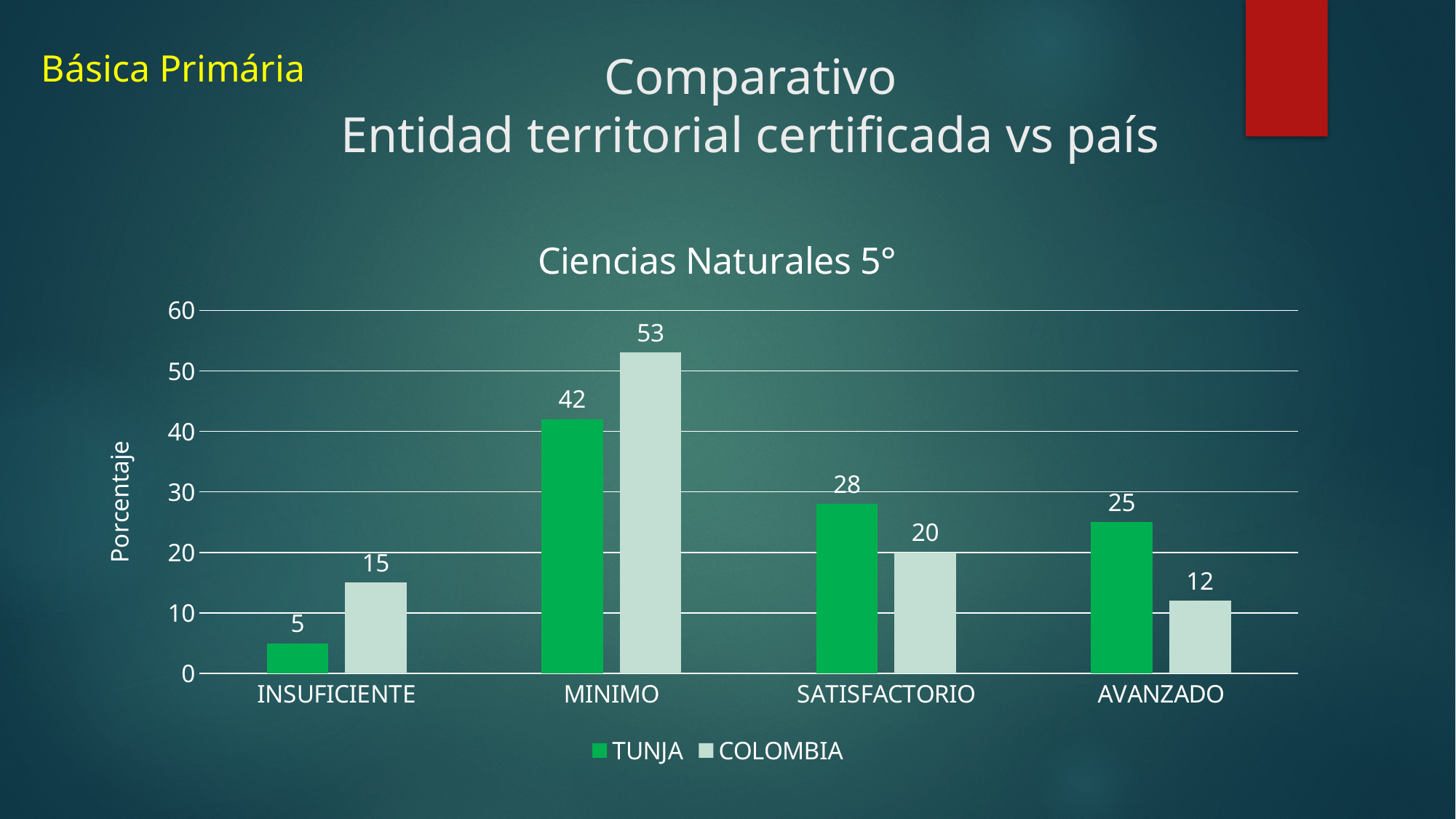
What is the value for COLOMBIA in the AVANZADO category? 12 Which category has the highest value for COLOMBIA? MINIMO Which category has the lowest value for TUNJA? INSUFICIENTE What is the value for COLOMBIA in the INSUFICIENTE category? 15 How many categories are shown on the x axis? 4 What is the value for TUNJA in the MINIMO category? 42 What kind of chart is shown on the slide? bar chart In the SATISFACTORIO category, which series has the larger value, TUNJA or COLOMBIA? TUNJA How many series does the legend list? 2 Is the value for TUNJA in the AVANZADO category greater or less than 20? greater What is the title of the chart? Ciencias Naturales 5° What is the difference between the COLOMBIA and TUNJA values in the MINIMO category? 11